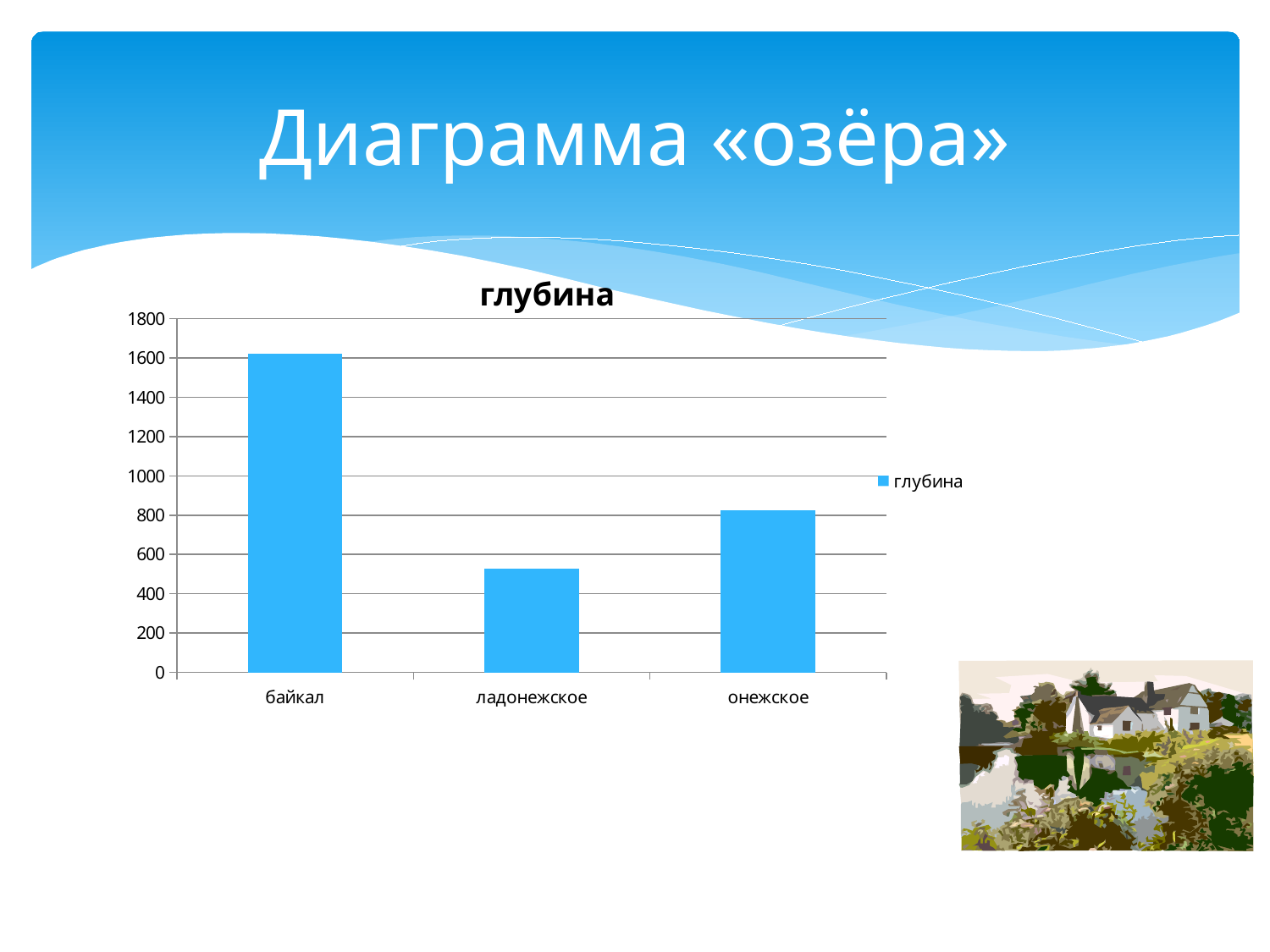
Is the value for байкал greater or less than 1400? greater Which lake has the lowest value in the chart? ладонежское Is the value for онежское greater or less than 1000? less What is the title of the chart? глубина What type of chart is shown on the slide? bar chart What is the name of the series shown in the chart legend? глубина How many series does the chart legend list? 1 Is the value for ладонежское greater or less than 600? less Which lake has the highest value in the chart? байкал How many categories (lakes) are shown on the x axis of the chart? 3 Which is larger, the value for онежское or the value for ладонежское? онежское Which is larger, the value for байкал or the value for онежское? байкал